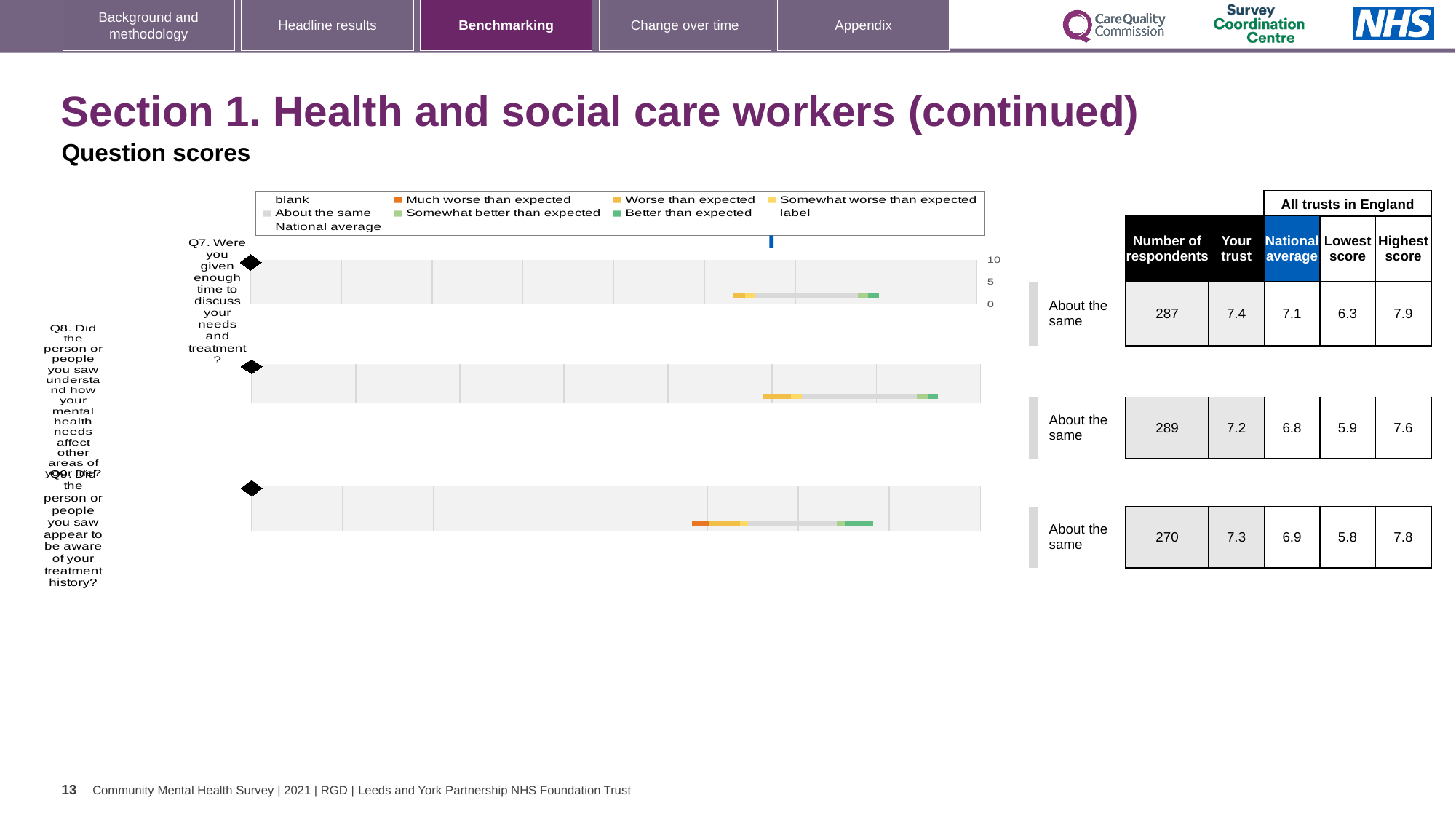
What is the lowest score across all trusts in England for Q8? 5.9 What benchmark category is shown for Q7? About the same What is the 'Your trust' score for Q7 (Were you given enough time to discuss your needs and treatment?)? 7.4 Which of the three questions (Q7, Q8, Q9) has the lowest 'Lowest score' across all trusts in England? Q9 For Q8, which is larger: the 'Your trust' score or the national average? Your trust What is the highest score across all trusts in England for Q9? 7.8 How many questions are benchmarked on this slide? 3 For Q7, how much higher is the 'Your trust' score than the national average? 0.3 For Q9, what is the difference between the highest score and the lowest score across all trusts in England? 2.0 How many respondents answered Q9 (Did the person or people you saw appear to be aware of your treatment history?)? 270 What is the national average score for Q8 (Did the person or people you saw understand how your mental health needs affect other areas of your life?)? 6.8 Which of the three questions (Q7, Q8, Q9) has the highest 'Your trust' score? Q7